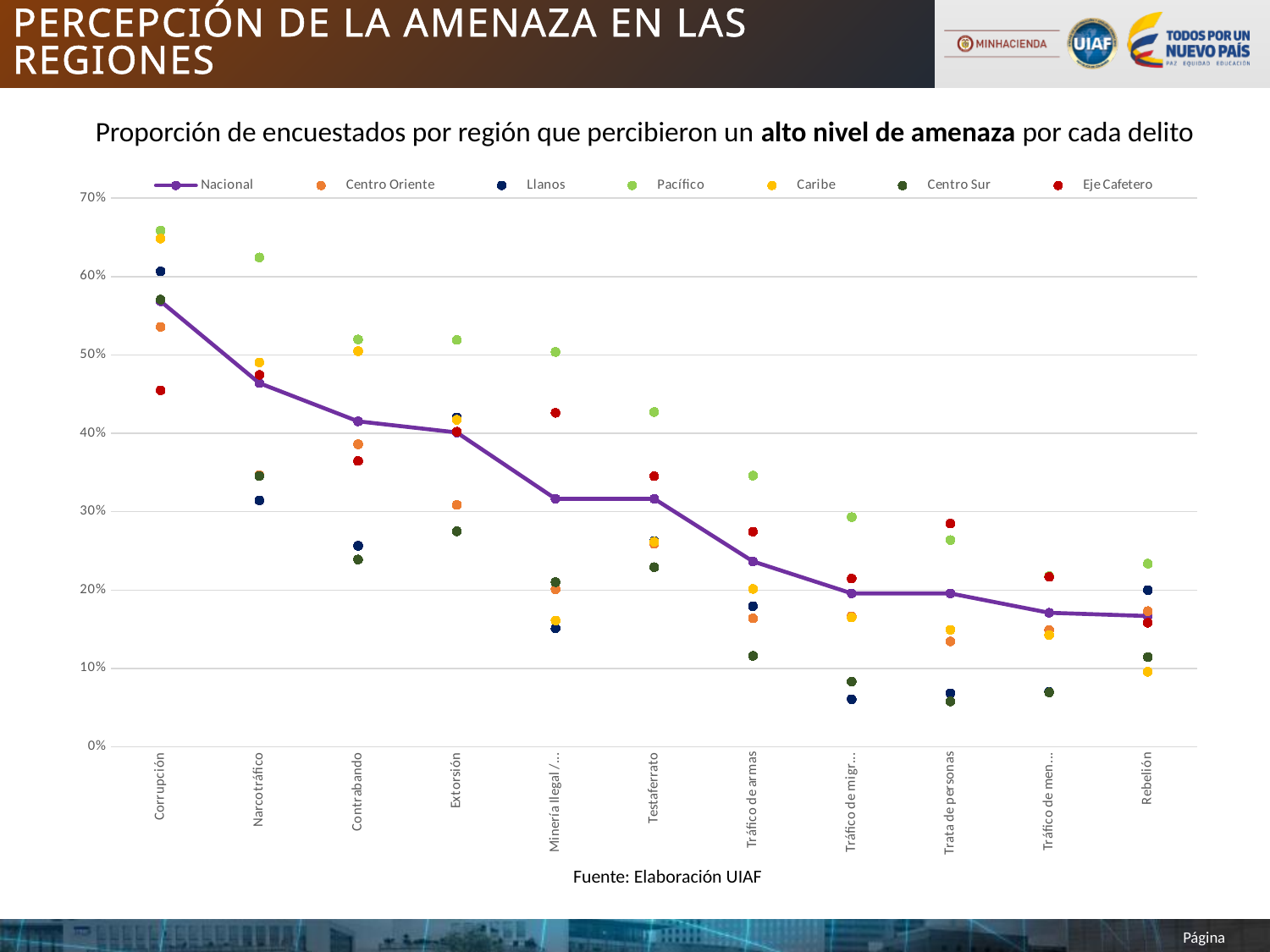
Does the Nacional line rise or fall from Corrupción to Rebelión along the x axis? fall For which category is the Nacional value highest? Corrupción Is the Nacional value for Rebelión greater or less than 20%? less What kind of chart is used to plot the Nacional series? line chart How many crime categories are shown on the x axis? 11 How many series does the legend list? 7 Is the Nacional value for Corrupción greater or less than 50%? greater Is the Nacional value for Narcotráfico greater or less than 50%? less Which is larger for Narcotráfico: the Pacífico value or the Llanos value? Pacífico What source is cited below the chart? Fuente: Elaboración UIAF Which is larger for the Nacional series: Corrupción or Tráfico de armas? Corrupción